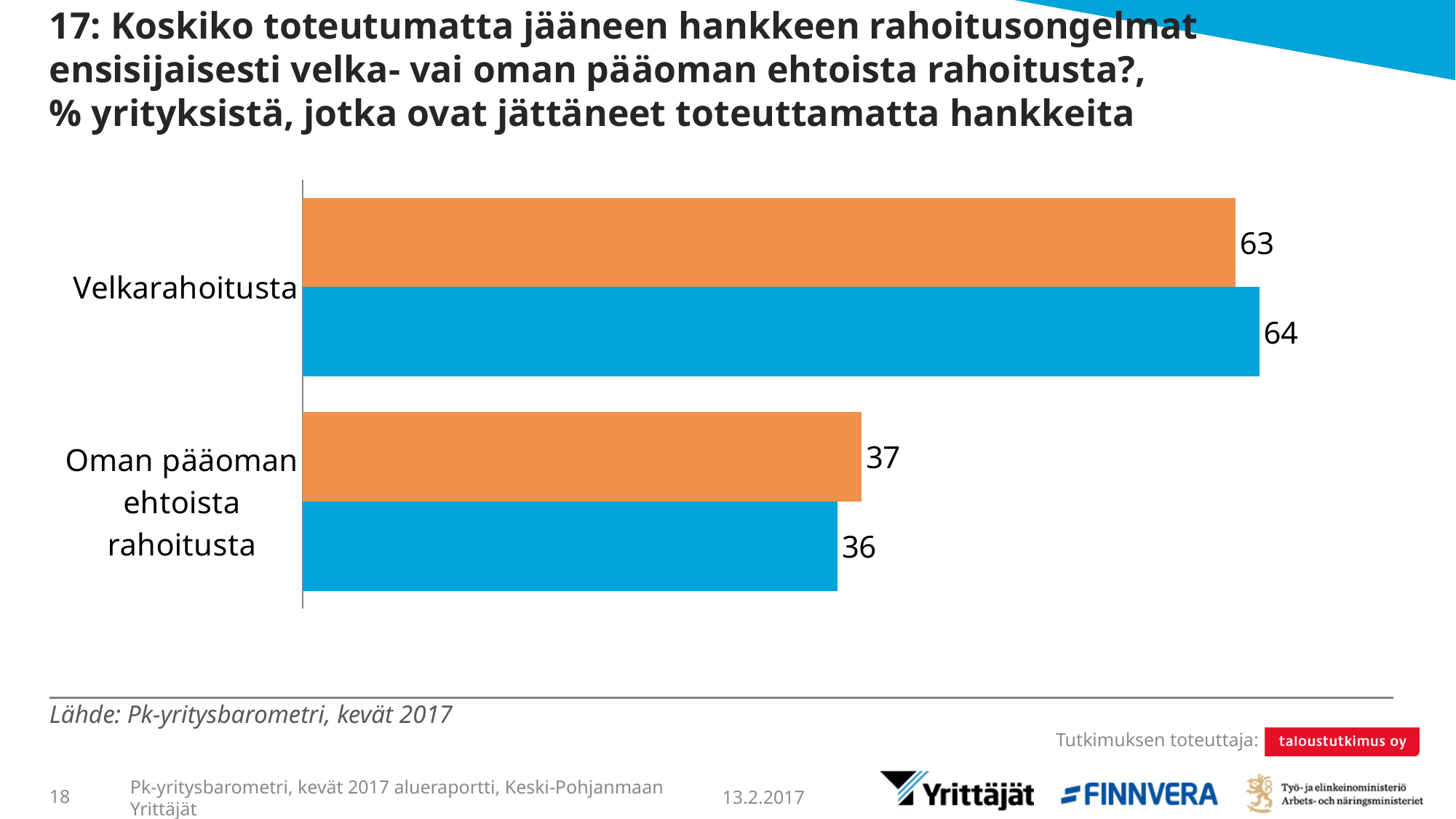
Which is larger: the orange bar for Velkarahoitusta or the orange bar for Oman pääoman ehtoista rahoitusta? Velkarahoitusta What source is cited below the chart? Pk-yritysbarometri, kevät 2017 What is the difference between the orange bar values for Velkarahoitusta and Oman pääoman ehtoista rahoitusta? 26 Which category has the lowest orange bar value? Oman pääoman ehtoista rahoitusta What is the value of the orange bar for Velkarahoitusta? 63 What is the value of the blue bar for Oman pääoman ehtoista rahoitusta? 36 What is the value of the blue bar for Velkarahoitusta? 64 Which category has the highest blue bar value? Velkarahoitusta What is the difference between the blue bar values for Velkarahoitusta and Oman pääoman ehtoista rahoitusta? 28 How many categories are shown on the chart? 2 What kind of chart is shown on the slide? Bar chart What is the value of the orange bar for Oman pääoman ehtoista rahoitusta? 37